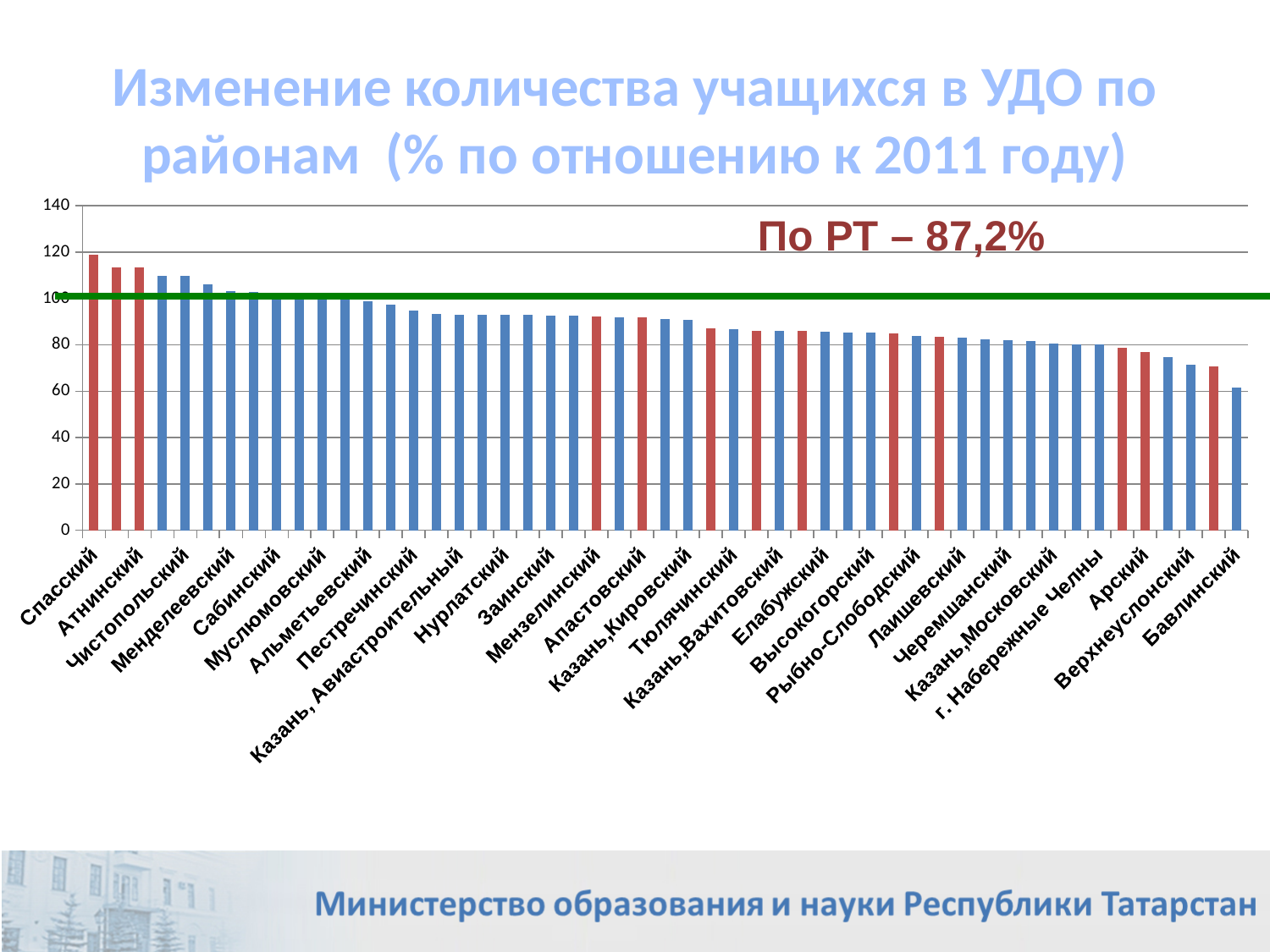
Is the value for Верхнеуслонский greater or less than 80? less Is the value for Спасский greater or less than 100? greater Is the value for Чистопольский greater or less than 100? greater Do the bar values rise or fall from left to right along the x axis? fall Which district has the highest value in the chart? Спасский Which district has the lowest value in the chart? Бавлинский Which is larger, the value for Спасский or the value for Бавлинский? Спасский Which is larger, the value for Чистопольский or the value for Верхнеуслонский? Чистопольский What kind of chart is shown on the slide? bar chart What is the title of the chart? Изменение количества учащихся в УДО по районам (% по отношению к 2011 году) What overall value for the Republic of Tatarstan (По РТ) is printed on the chart? 87,2%